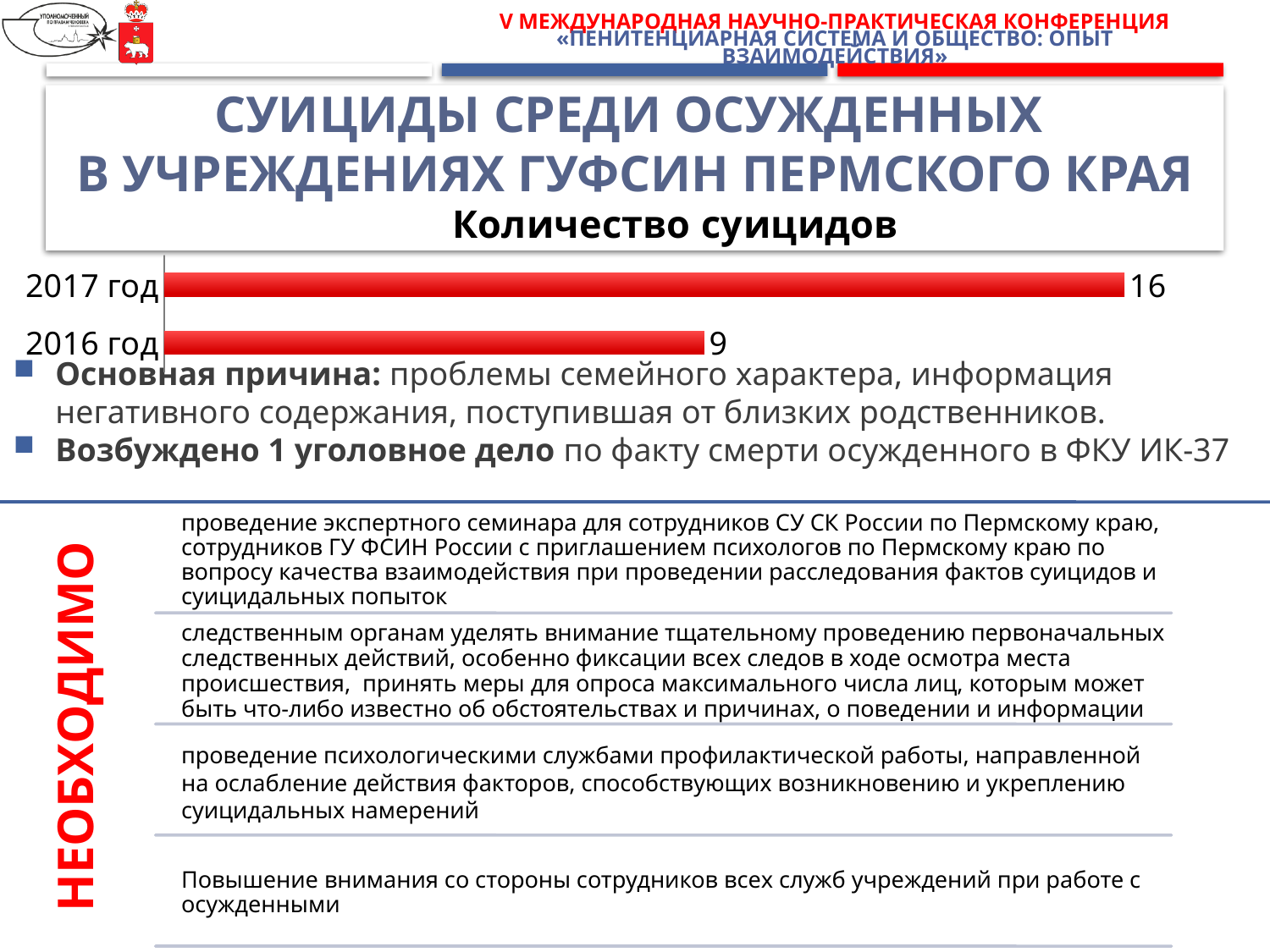
Which year has the lower number of suicides? 2016 год Is the value for 2017 год larger or smaller than the value for 2016 год? larger What is the number of suicides shown for 2017 год? 16 What is the title of the chart? Количество суицидов By how much does the value for 2017 год exceed the value for 2016 год? 7 Which year has the higher number of suicides? 2017 год What kind of chart is used to show the number of suicides? bar chart What is the number of suicides shown for 2016 год? 9 What is the total number of suicides across 2016 and 2017 combined? 25 What colour are the bars in the chart? red Did the number of suicides rise or fall from 2016 to 2017? rise How many years (categories) are shown in the chart? 2